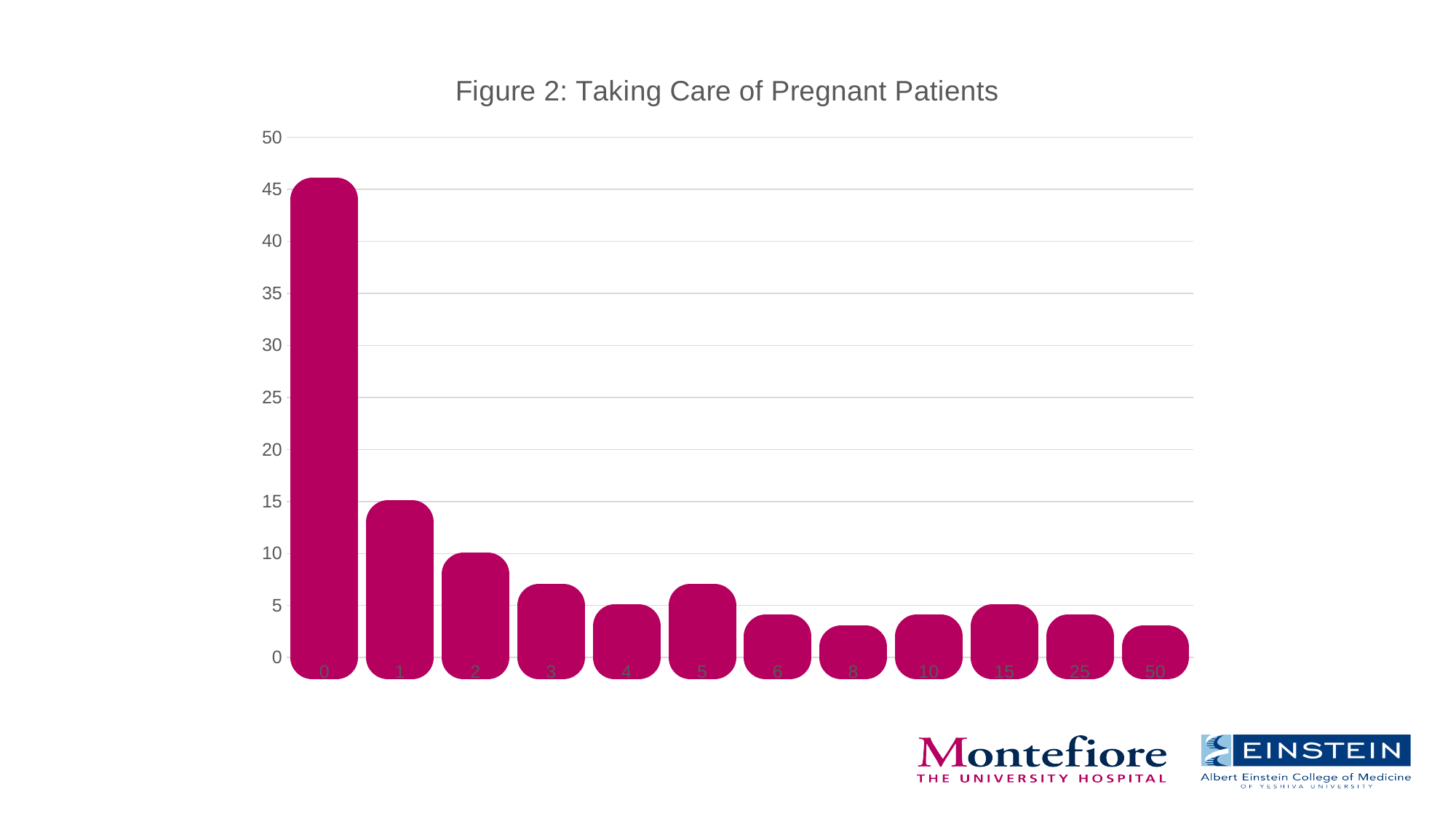
How many categories are shown on the x axis? 12 What is the title of the chart? Figure 2: Taking Care of Pregnant Patients Which category has the highest bar? 0 What type of chart is shown on the slide? bar chart Is the value for category 8 greater or less than 5? less Which is larger, the value for category 1 or the value for category 2? 1